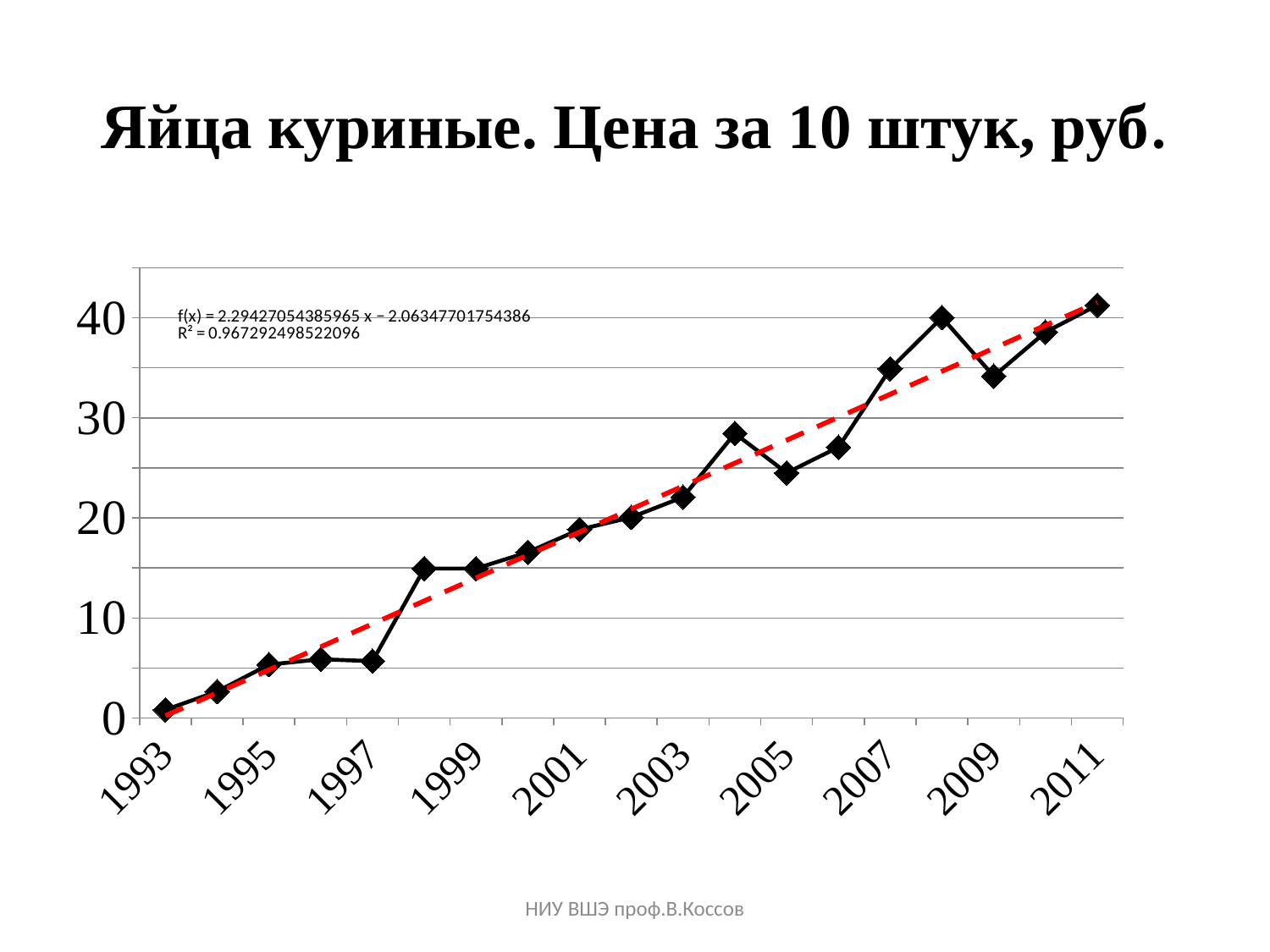
What kind of chart is shown on the slide? line chart Is the value for 1997 greater or less than 10? less Do the values generally rise or fall from 1993 to 2011? rise Is the value for 2004 greater or less than 20? greater How many data points are plotted on the line? 19 What is the title of the chart? Яйца куриные. Цена за 10 штук, руб. Is the value for 2008 greater or less than 30? greater Which is larger, the value for 2008 or the value for 2009? 2008 What R² value is printed for the trendline? 0.967292498522096 Which is larger, the value for 2004 or the value for 2005? 2004 Which year has the lowest value? 1993